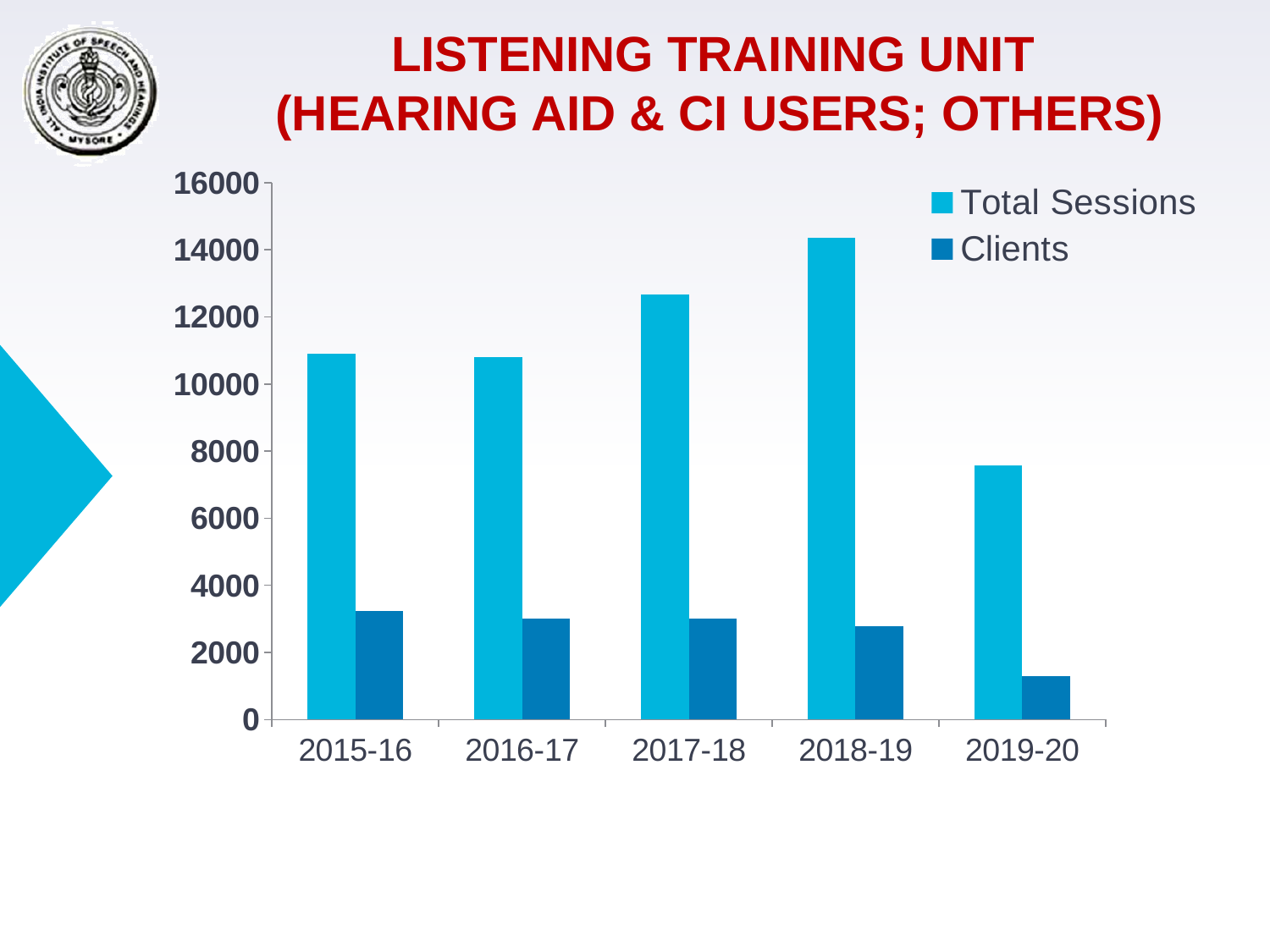
How many year categories are shown on the x axis? 5 Which year has the highest value for Total Sessions? 2018-19 Which series is shown in the darker blue bars? Clients Which is larger, Total Sessions in 2017-18 or Total Sessions in 2016-17? 2017-18 What kind of chart is shown on the slide? bar chart Is the value for Total Sessions in 2019-20 greater or less than 8000? less Do the Clients values rise or fall from 2015-16 to 2019-20? fall Is the value for Clients in 2019-20 greater or less than 2000? less Which year has the lowest value for Clients? 2019-20 Which year has the lowest value for Total Sessions? 2019-20 Is the value for Total Sessions in 2017-18 greater or less than 12000? greater How many series does the legend list? 2